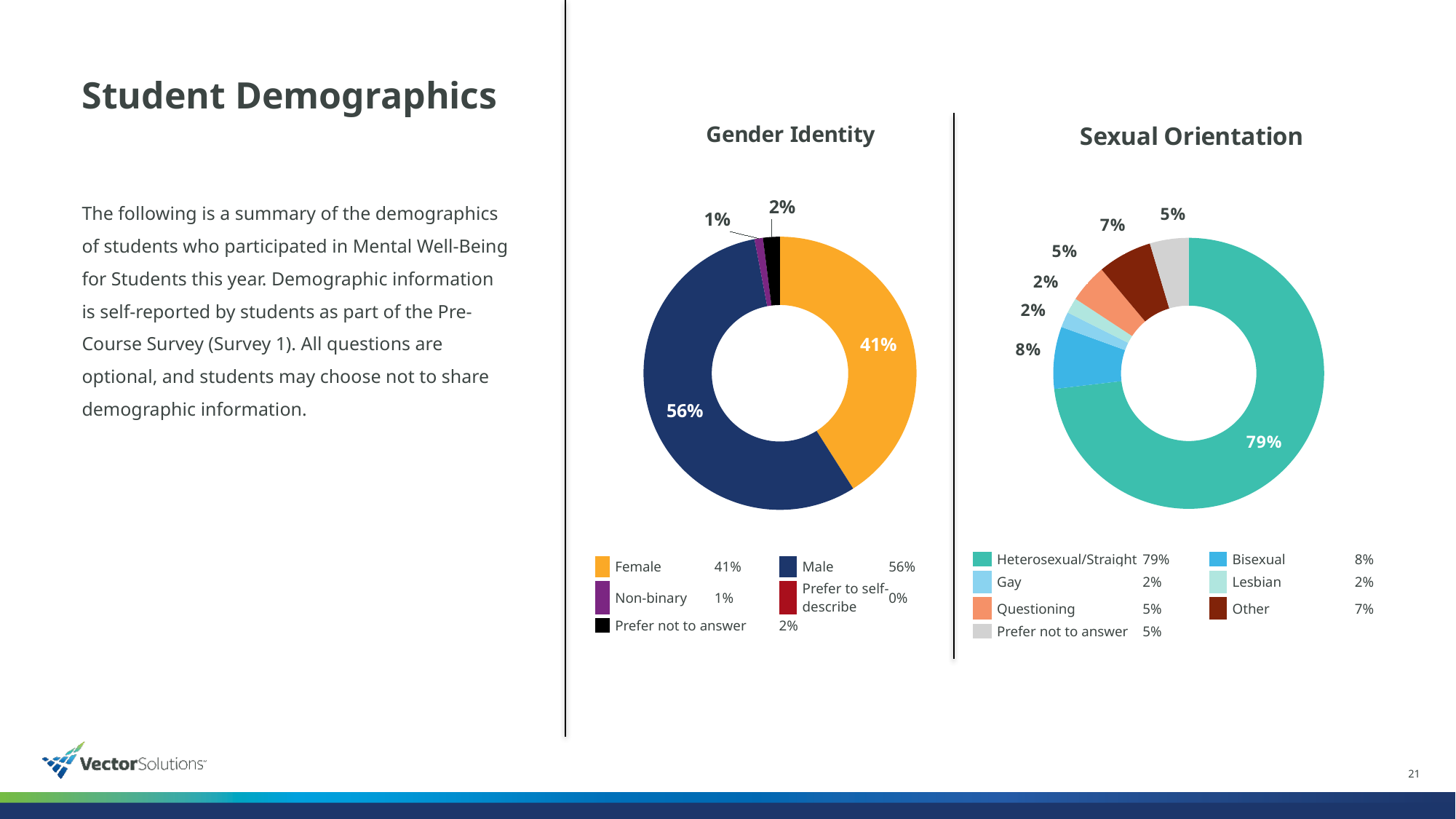
In the Sexual Orientation chart, what percentage of students identified as Heterosexual/Straight? 79% In the Gender Identity chart, what percentage chose Prefer not to answer? 2% In the Gender Identity chart, which category has the largest share? Male In the Sexual Orientation chart, what percentage of students identified as Bisexual? 8% In the Gender Identity chart, what is the difference between the Male and Female percentages? 15% What kind of chart is the Sexual Orientation chart? Doughnut (pie) chart In the Sexual Orientation chart, which is larger, Questioning or Other? Other In the Gender Identity chart, what percentage of students identified as Female? 41% In the Sexual Orientation chart, how many categories does the legend list? 7 In the Gender Identity chart, what percentage of students identified as Male? 56% In the Gender Identity chart, how many categories does the legend list? 5 In the Sexual Orientation chart, what is the difference between the Bisexual and Gay percentages? 6%